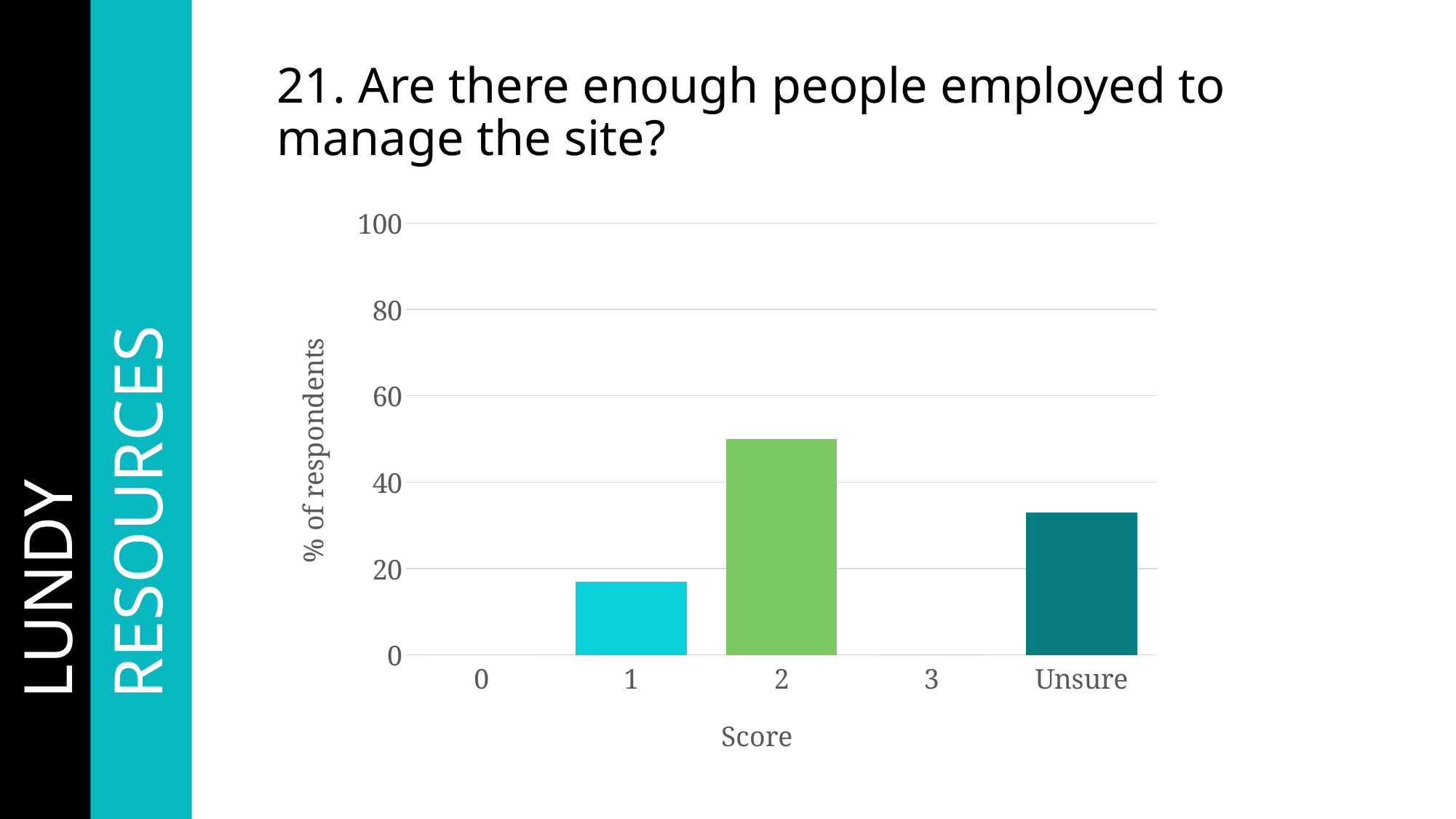
Is the value for Unsure greater or less than 20? greater Is the value for score 2 greater or less than 40? greater Is the value for score 2 greater or less than 60? less Which is larger, the value for score 2 or the value for Unsure? 2 Which score category has the highest percentage of respondents? 2 How many categories are shown on the x axis of the chart? 5 What kind of chart is shown on the slide? bar chart Which is larger, the value for score 1 or the value for Unsure? Unsure What is the label of the horizontal axis of the chart? Score What is the label of the vertical axis of the chart? % of respondents